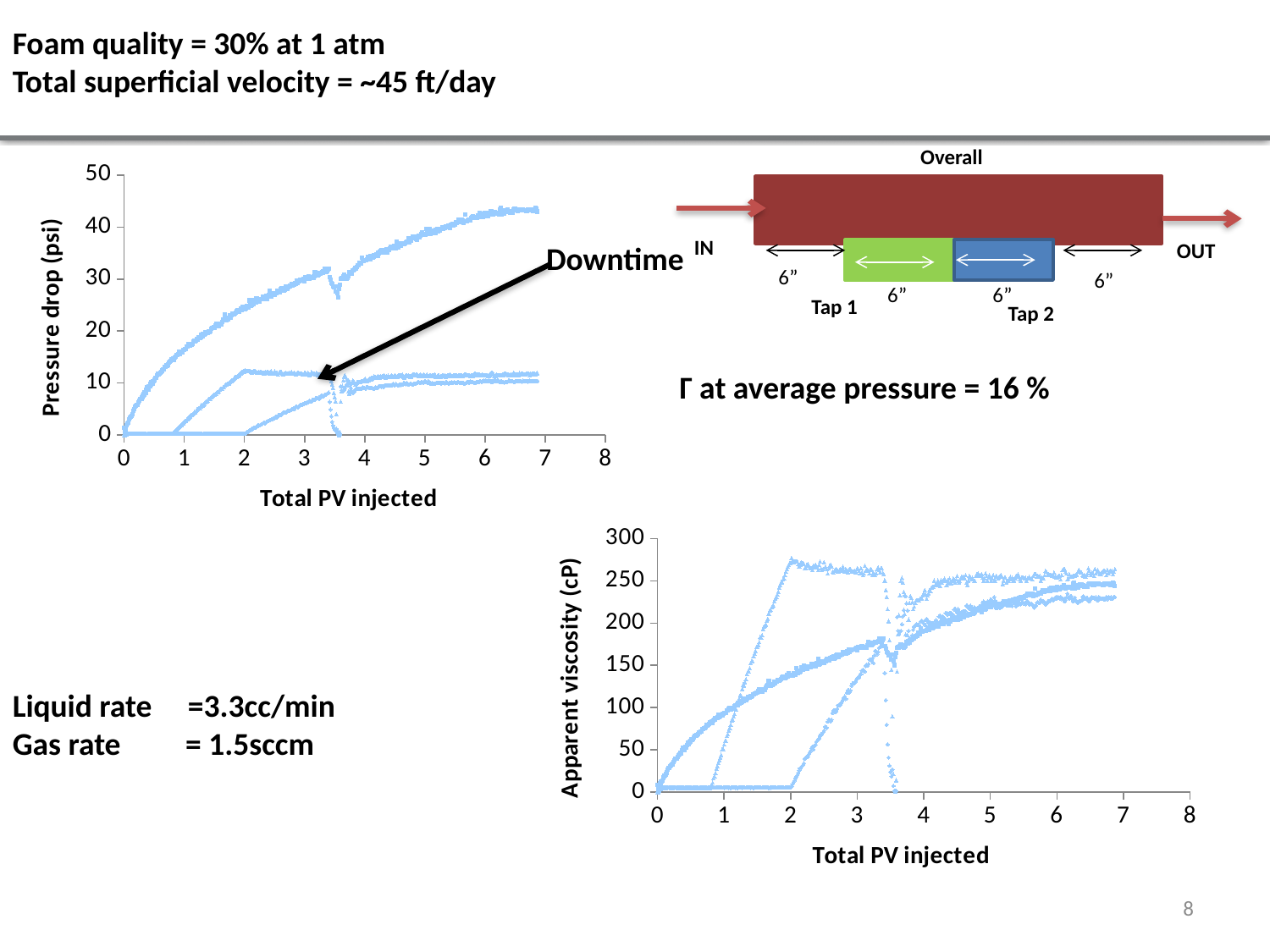
What is the y-axis title of the top-left chart? Pressure drop (psi) In the top-left chart, does the uppermost curve generally rise or fall as Total PV injected increases? rise In the bottom-right chart, is the peak apparent viscosity greater or less than 300? less In the bottom-right chart, is the peak apparent viscosity reached near 2 PV injected greater or less than 250? greater What kind of chart is the top-left chart on the slide? Scatter chart In the top-left chart, is the highest pressure drop reached by the uppermost curve greater or less than 40? greater What is the maximum tick value on the x axis of the bottom-right chart? 8 In the bottom-right chart, does the curve that starts rising at 0 PV injected rise or fall between 0 and 3 PV injected? rise What is the y-axis title of the bottom-right chart? Apparent viscosity (cP) How many separate curves are plotted in the top-left chart? 3